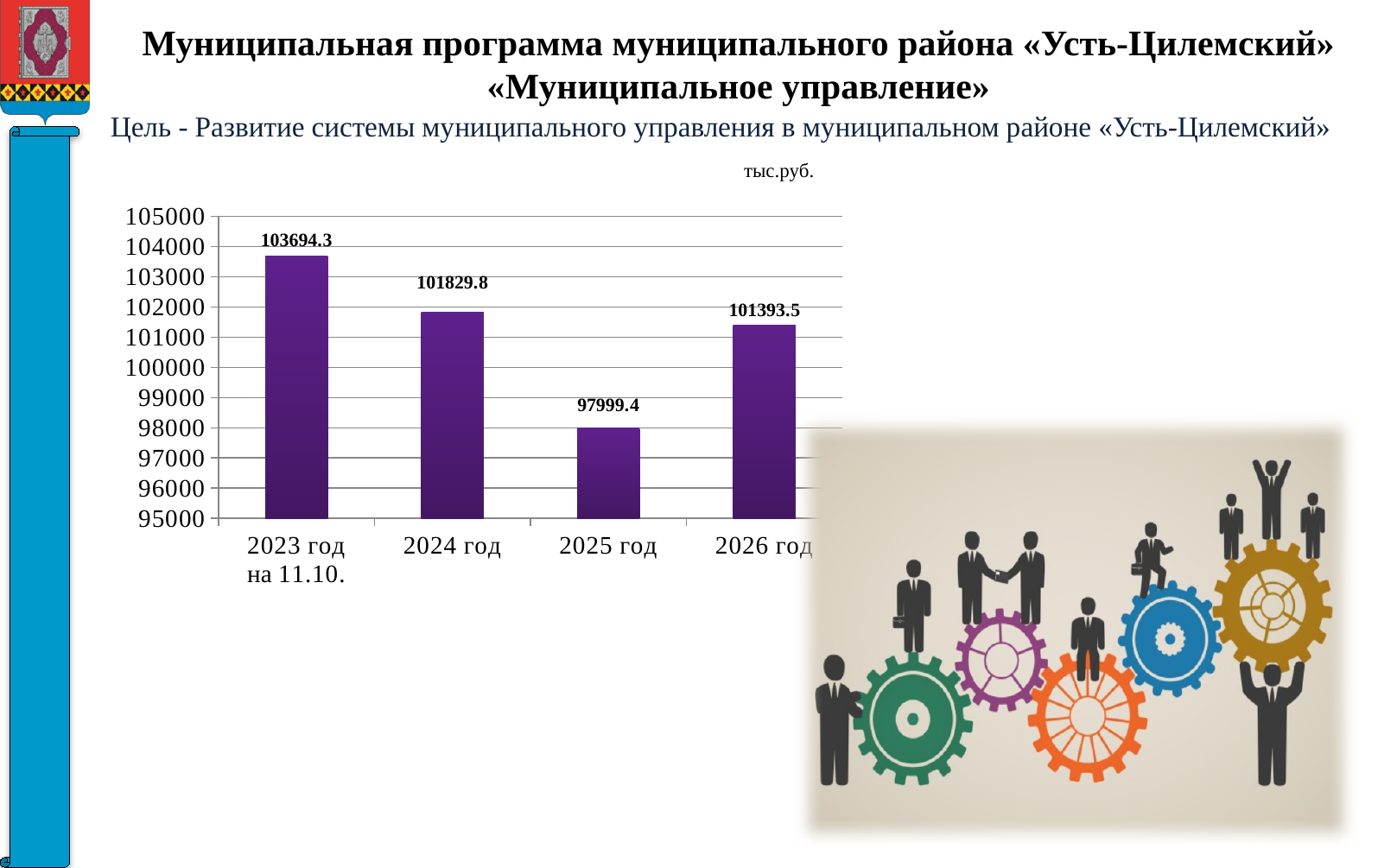
Is the value for 2025 год greater or less than 99000? less Which year has the highest value? 2023 год на 11.10. What is the value for 2024 год? 101829.8 What is the value for 2026 год? 101393.5 What is the value for 2023 год на 11.10.? 103694.3 What is the difference between the values for 2024 год and 2025 год? 3830.4 What is the difference between the values for 2023 год на 11.10. and 2026 год? 2300.8 Which is larger, the value for 2024 год or the value for 2026 год? 2024 год What kind of chart is shown on the slide? bar chart Which year has the lowest value? 2025 год How many bars are shown in the chart? 4 What is the value for 2025 год? 97999.4